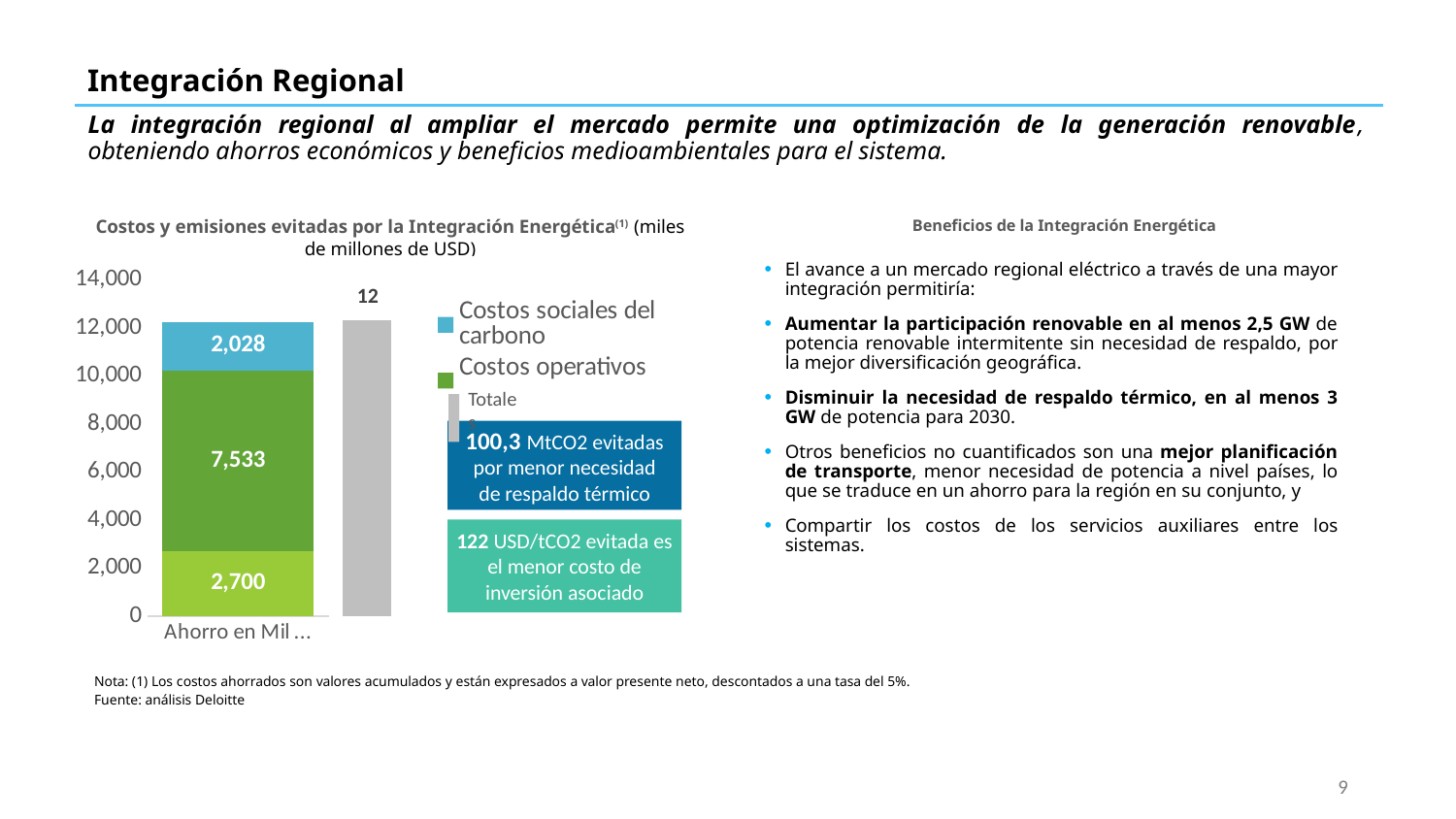
In the chart 'Costos y emisiones evitadas por la Integración Energética', what is the highest value shown on the vertical axis? 14,000 In the chart 'Costos y emisiones evitadas por la Integración Energética', which segment of the stacked bar has the smallest value? Costos sociales del carbono (2,028) In the chart 'Costos y emisiones evitadas por la Integración Energética', which segment of the stacked bar has the largest value? Costos operativos (7,533) In the chart 'Costos y emisiones evitadas por la Integración Energética', how many segments make up the stacked bar? 3 In the chart 'Costos y emisiones evitadas por la Integración Energética', what is the difference between the 'Costos operativos' segment and the 'Costos sociales del carbono' segment? 5,505 What kind of chart is 'Costos y emisiones evitadas por la Integración Energética'? Stacked bar chart In the chart 'Costos y emisiones evitadas por la Integración Energética', what is the value of the 'Costos operativos' segment? 7,533 In the chart 'Costos y emisiones evitadas por la Integración Energética', what is the value of the 'Costos sociales del carbono' segment? 2,028 In the chart 'Costos y emisiones evitadas por la Integración Energética', is the grey total bar greater or less than 10,000? greater In the chart 'Costos y emisiones evitadas por la Integración Energética', what is the total of the three segments in the stacked bar? 12,261 In the chart 'Costos y emisiones evitadas por la Integración Energética', which is larger: 'Costos operativos' or 'Costos sociales del carbono'? Costos operativos In the chart 'Costos y emisiones evitadas por la Integración Energética', what is the value of the bottom (light green) segment of the stacked bar? 2,700